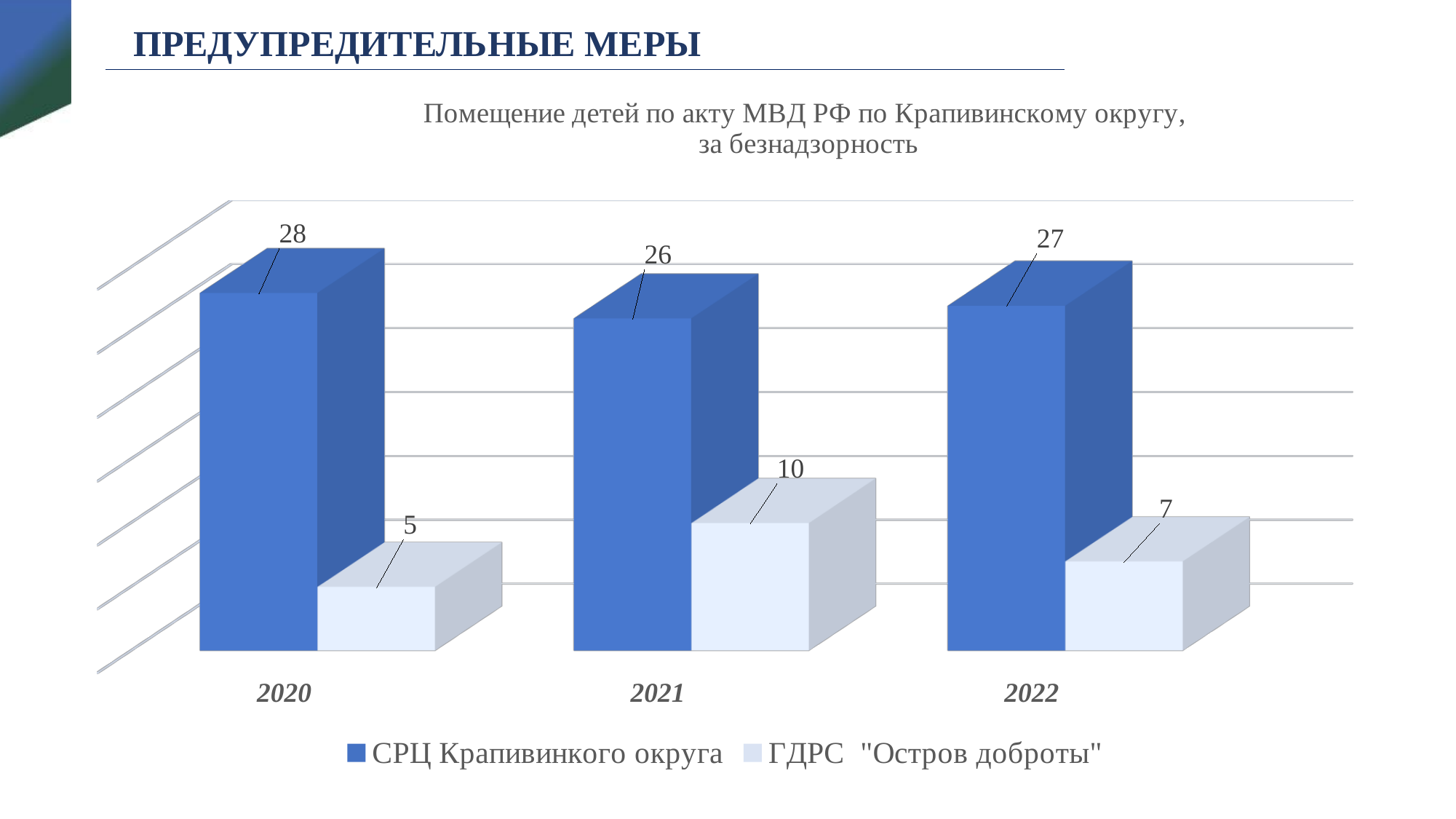
Which is larger in 2021: the value for СРЦ Крапивинкого округа or for ГДРС "Остров доброты"? СРЦ Крапивинкого округа How many years are shown on the x axis? 3 What is the value for ГДРС "Остров доброты" in 2021? 10 What is the title of the chart? Помещение детей по акту МВД РФ по Крапивинскому округу, за безнадзорность In which year is the value for ГДРС "Остров доброты" lowest? 2020 How many series does the legend list? 2 What is the difference between the СРЦ Крапивинкого округа value and the ГДРС "Остров доброты" value in 2022? 20 What is the value for ГДРС "Остров доброты" in 2022? 7 In which year is the value for СРЦ Крапивинкого округа highest? 2020 What kind of chart is shown on the slide? bar chart What is the value for СРЦ Крапивинкого округа in 2020? 28 What is the value for СРЦ Крапивинкого округа in 2021? 26